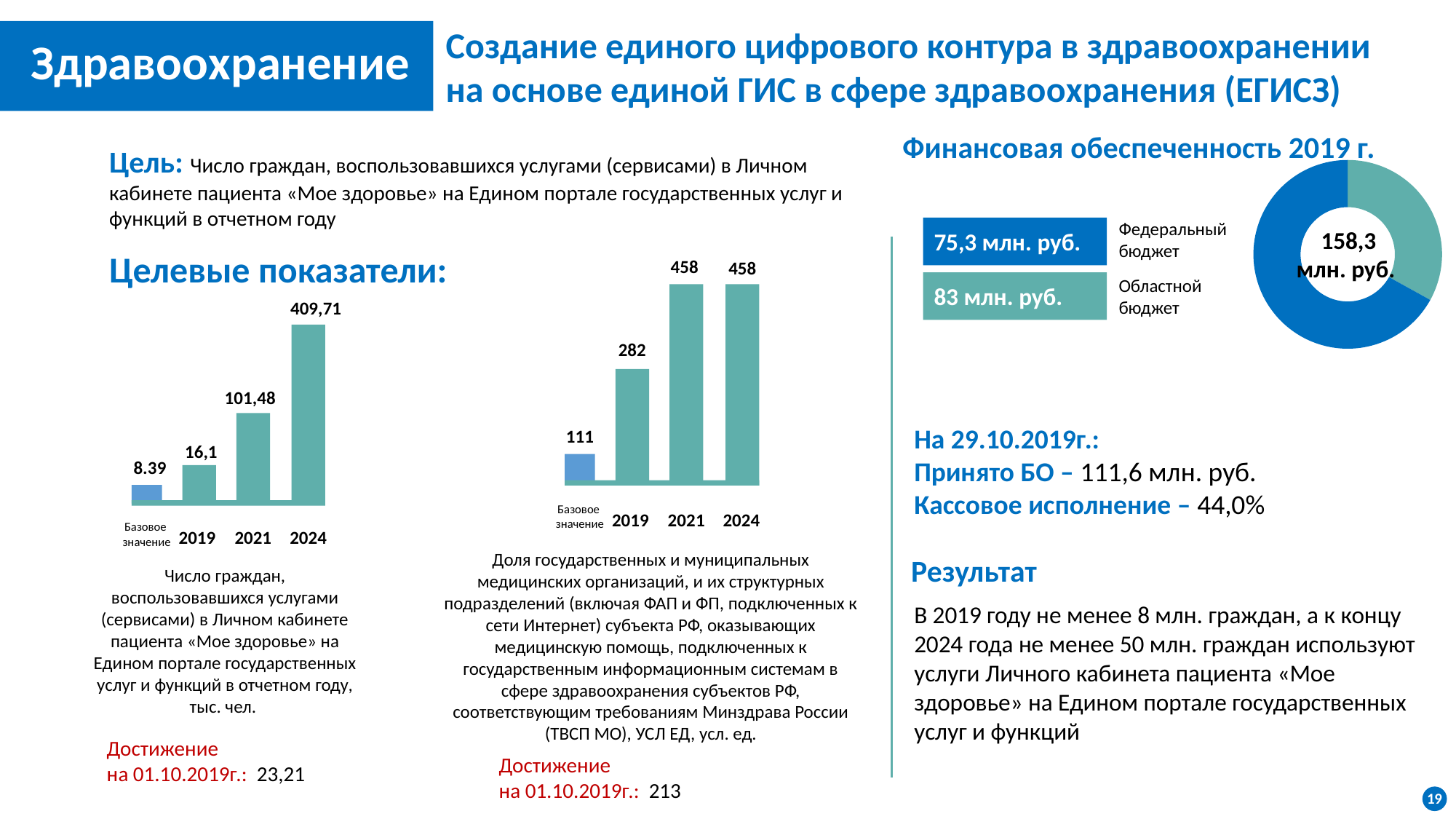
In the donut chart on the right, what is the value for Областной бюджет? 83 млн. руб. In the donut chart on the right, which is larger: Федеральный бюджет or Областной бюджет? Областной бюджет In the middle bar chart, how many bars are plotted? 4 In the left bar chart, do the values rise or fall from the base value to 2024? rise In the left bar chart, what is the value for 2024? 409,71 In the middle bar chart, what is the value for 2024? 458 What kind of chart is the chart under the heading 'Финансовая обеспеченность 2019 г.'? donut (pie) chart In the middle bar chart, what is the difference between the 2019 value and the base value (Базовое значение)? 171 In the middle bar chart, what is the value for 2019? 282 In the left bar chart, which category has the lowest value? Базовое значение In the left bar chart, what is the value for 2021? 101,48 In the left bar chart, what is the value for the base value (Базовое значение) bar? 8.39